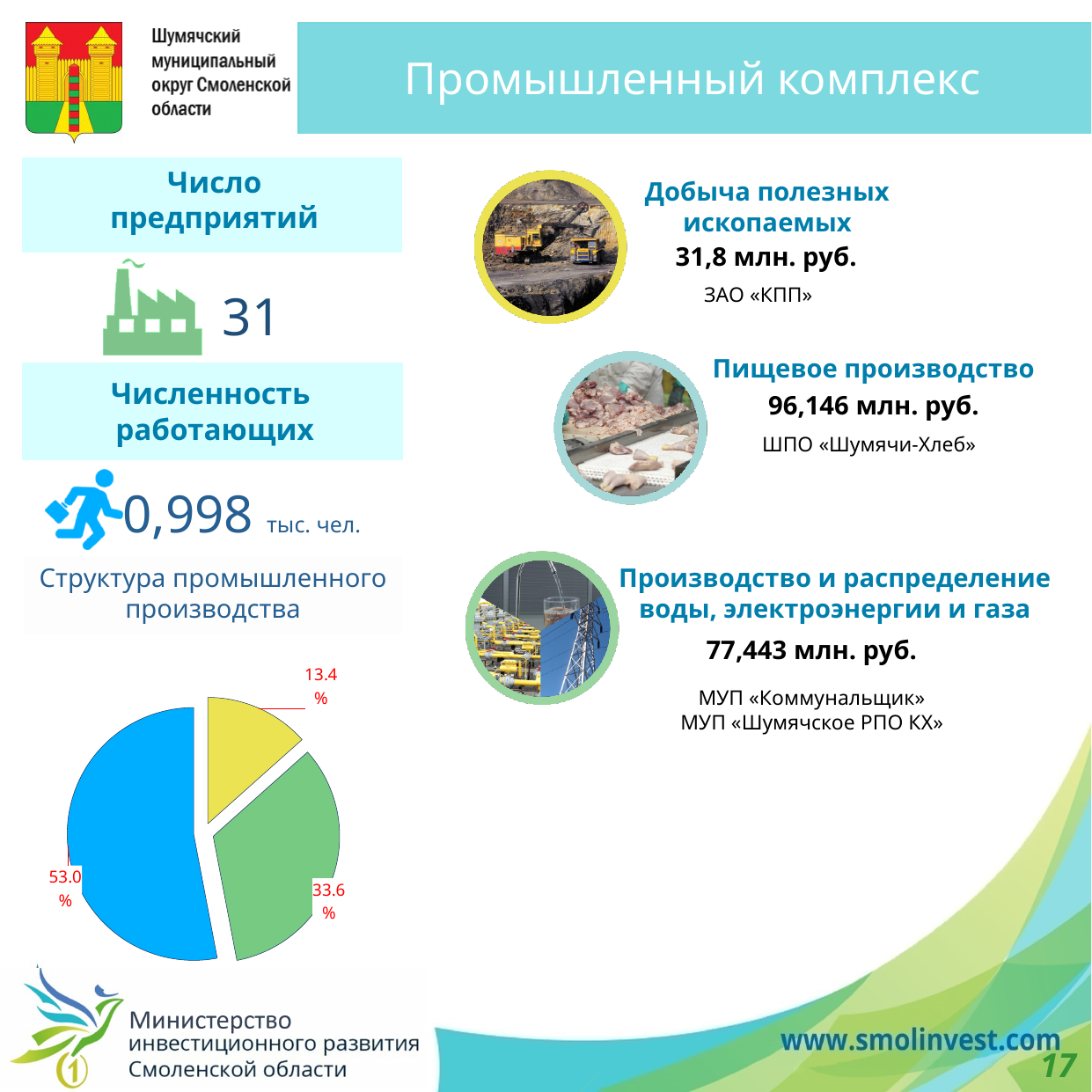
In the pie chart "Структура промышленного производства", by how many percentage points does the green slice exceed the yellow slice? 20.2 percentage points Which slice of the pie chart "Структура промышленного производства" is the largest? the blue slice (53.0%) How many slices does the pie chart "Структура промышленного производства" have? 3 In the pie chart "Структура промышленного производства", which is larger: the green slice or the yellow slice? the green slice In the pie chart "Структура промышленного производства", by how many percentage points does the blue slice exceed the green slice? 19.4 percentage points In the pie chart "Структура промышленного производства", what share is shown for the blue slice? 53.0% Which slice of the pie chart "Структура промышленного производства" is the smallest? the yellow slice (13.4%) In the pie chart "Структура промышленного производства", what share is shown for the yellow slice? 13.4% Is the share of the blue slice in the pie chart "Структура промышленного производства" greater or less than 50%? greater What is the title shown above the pie chart on the slide? Структура промышленного производства What kind of chart is shown under the heading "Структура промышленного производства"? pie chart In the pie chart "Структура промышленного производства", what share is shown for the green slice? 33.6%